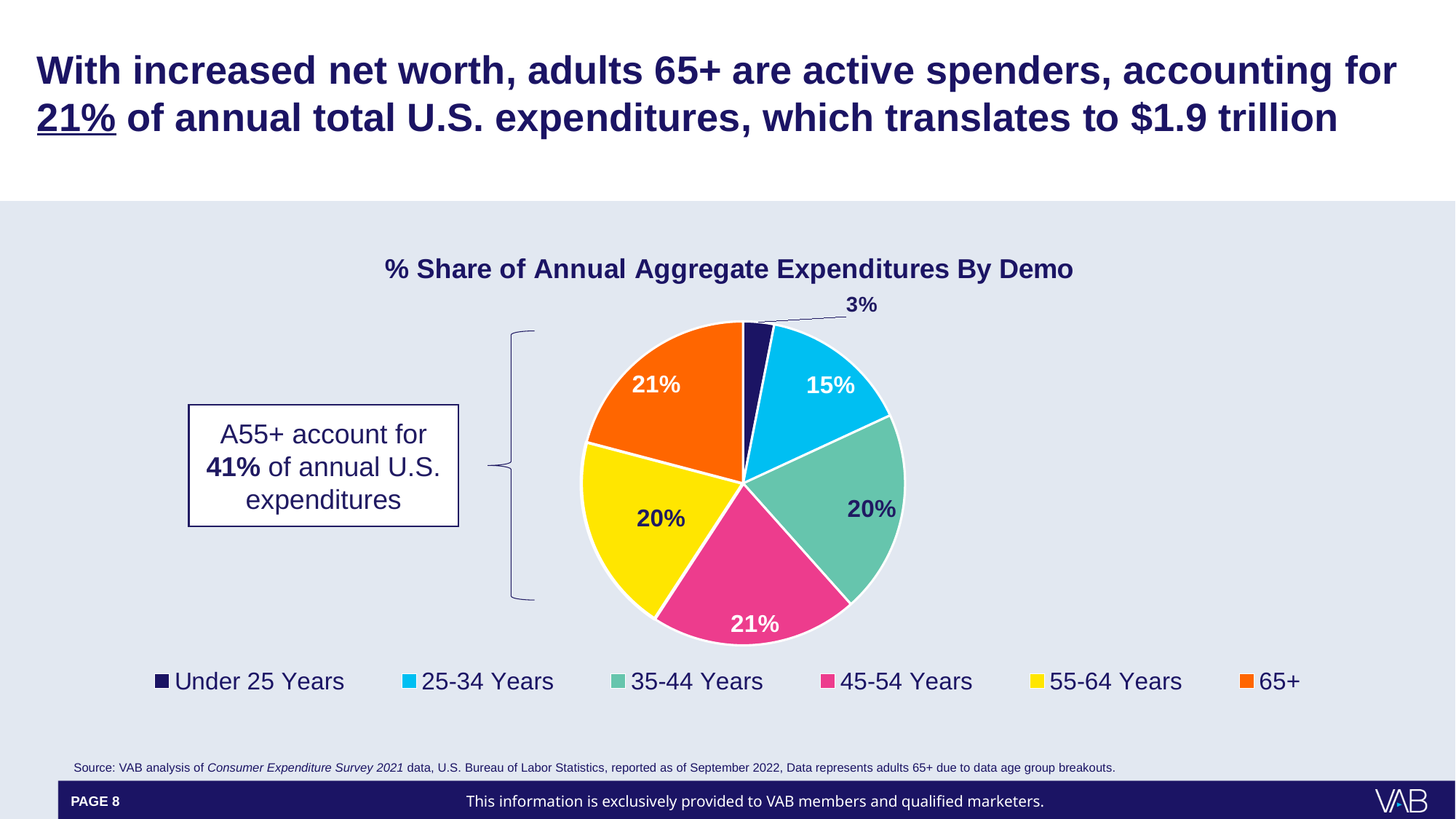
What type of chart is shown on the slide? Pie chart What is the difference in share between the 45-54 Years group and the 25-34 Years group? 6% How many age groups are shown in the pie chart? 6 What share of annual aggregate expenditures does the 25-34 Years group account for? 15% Which has a larger share of expenditures, the 25-34 Years group or the 35-44 Years group? 35-44 Years What share of annual aggregate expenditures does the 35-44 Years group account for? 20% Which age group has the smallest share of annual aggregate expenditures? Under 25 Years What share of annual aggregate expenditures does the 65+ group account for? 21% What colour represents the 65+ group in the pie chart? Orange What share of annual aggregate expenditures does the 55-64 Years group account for? 20% What share of annual aggregate expenditures does the Under 25 Years group account for? 3% What is the title of the chart? % Share of Annual Aggregate Expenditures By Demo